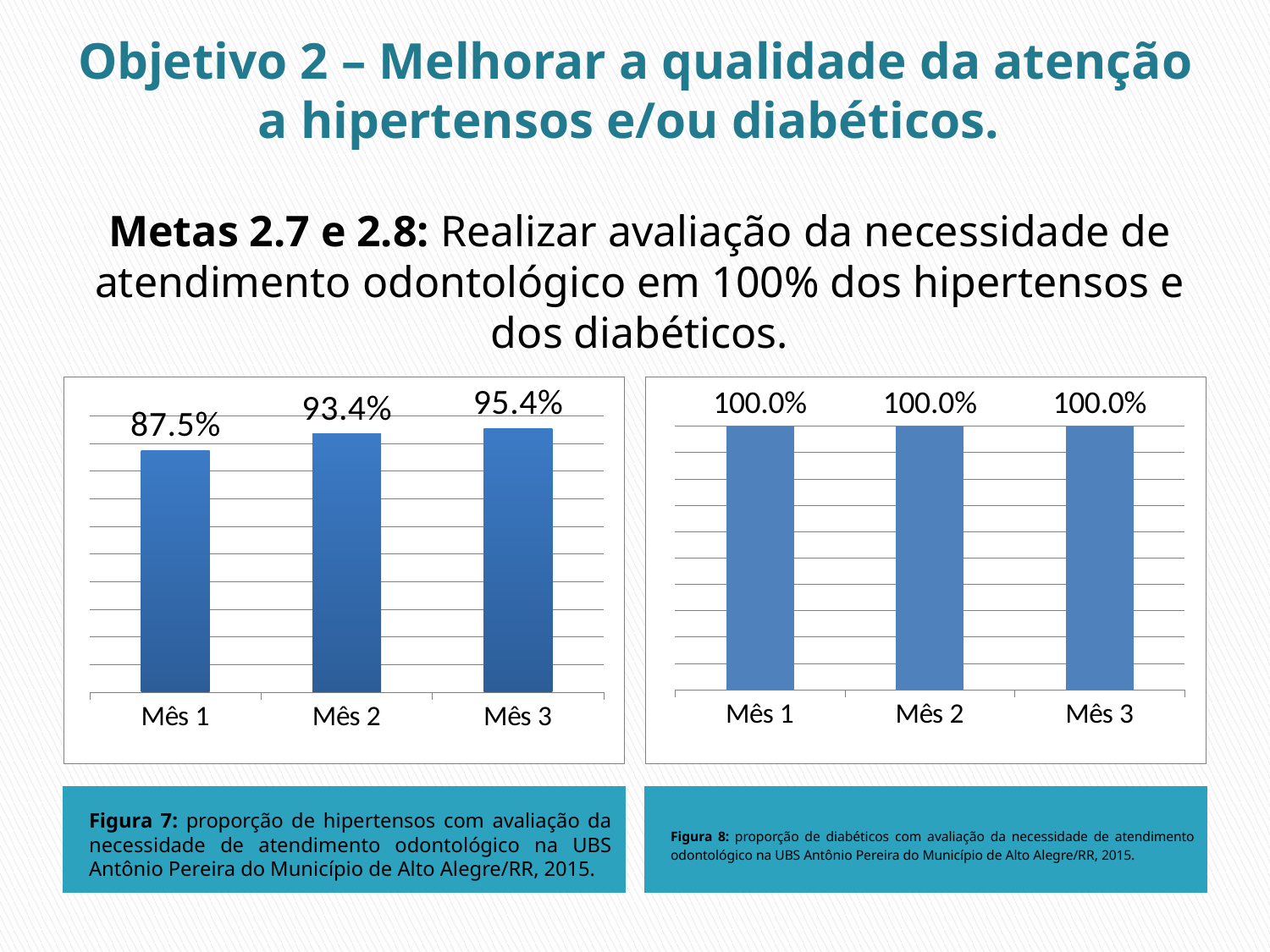
In the right chart (Figura 8, diabéticos), do the values change from Mês 1 to Mês 3? No, they stay at 100.0% In the left chart (Figura 7, hipertensos), what is the difference between the values for Mês 3 and Mês 1? 7.9% What type of chart is the left chart (Figura 7)? bar chart In the left chart (Figura 7, hipertensos), what is the value for Mês 1? 87.5% How many charts are shown on the slide? 2 In the left chart (Figura 7, hipertensos), do the values rise or fall from Mês 1 to Mês 3? rise In the left chart (Figura 7, hipertensos), what is the value for Mês 3? 95.4% In the left chart (Figura 7, hipertensos), which month has the highest value? Mês 3 In the right chart (Figura 8, diabéticos), what is the value for Mês 2? 100.0% In the left chart (Figura 7, hipertensos), which is larger, the value for Mês 2 or Mês 1? Mês 2 In the left chart (Figura 7, hipertensos), which month has the lowest value? Mês 1 In the right chart (Figura 8, diabéticos), how many months are plotted? 3